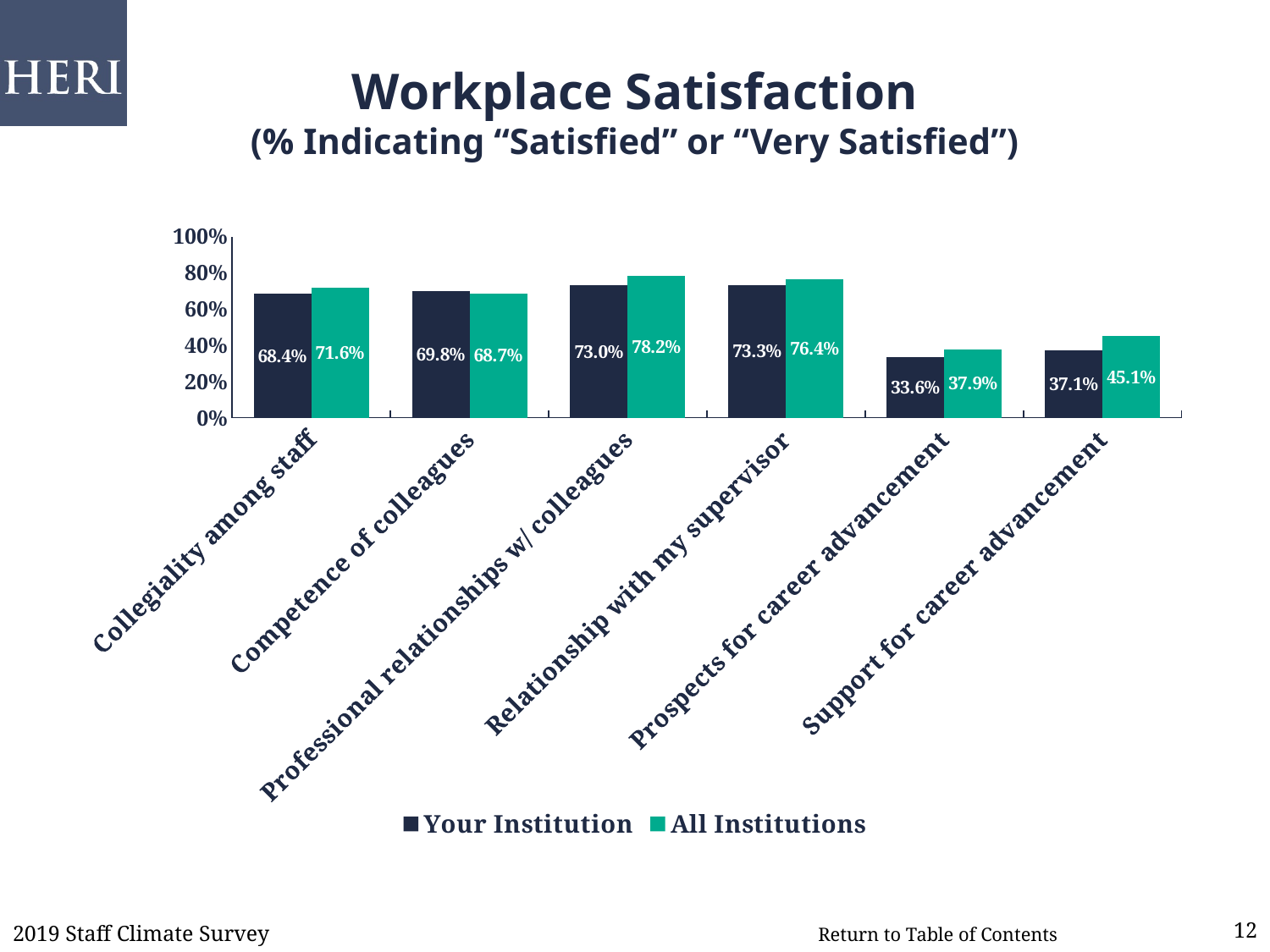
How many series does the legend list? 2 How many categories are shown on the x axis? 6 What is the title of the chart? Workplace Satisfaction What kind of chart is shown on the slide? Bar chart Is the value for Your Institution for Relationship with my supervisor greater or less than 60%? greater Which category has the highest value for All Institutions? Professional relationships w/ colleagues What is the value for Your Institution for Collegiality among staff? 68.4% What is the value for All Institutions for Support for career advancement? 45.1% What is the value for All Institutions for Professional relationships w/ colleagues? 78.2% What is the difference between All Institutions and Your Institution for Support for career advancement? 8.0% Which category has the lowest value for Your Institution? Prospects for career advancement For Competence of colleagues, which is larger: Your Institution or All Institutions? Your Institution